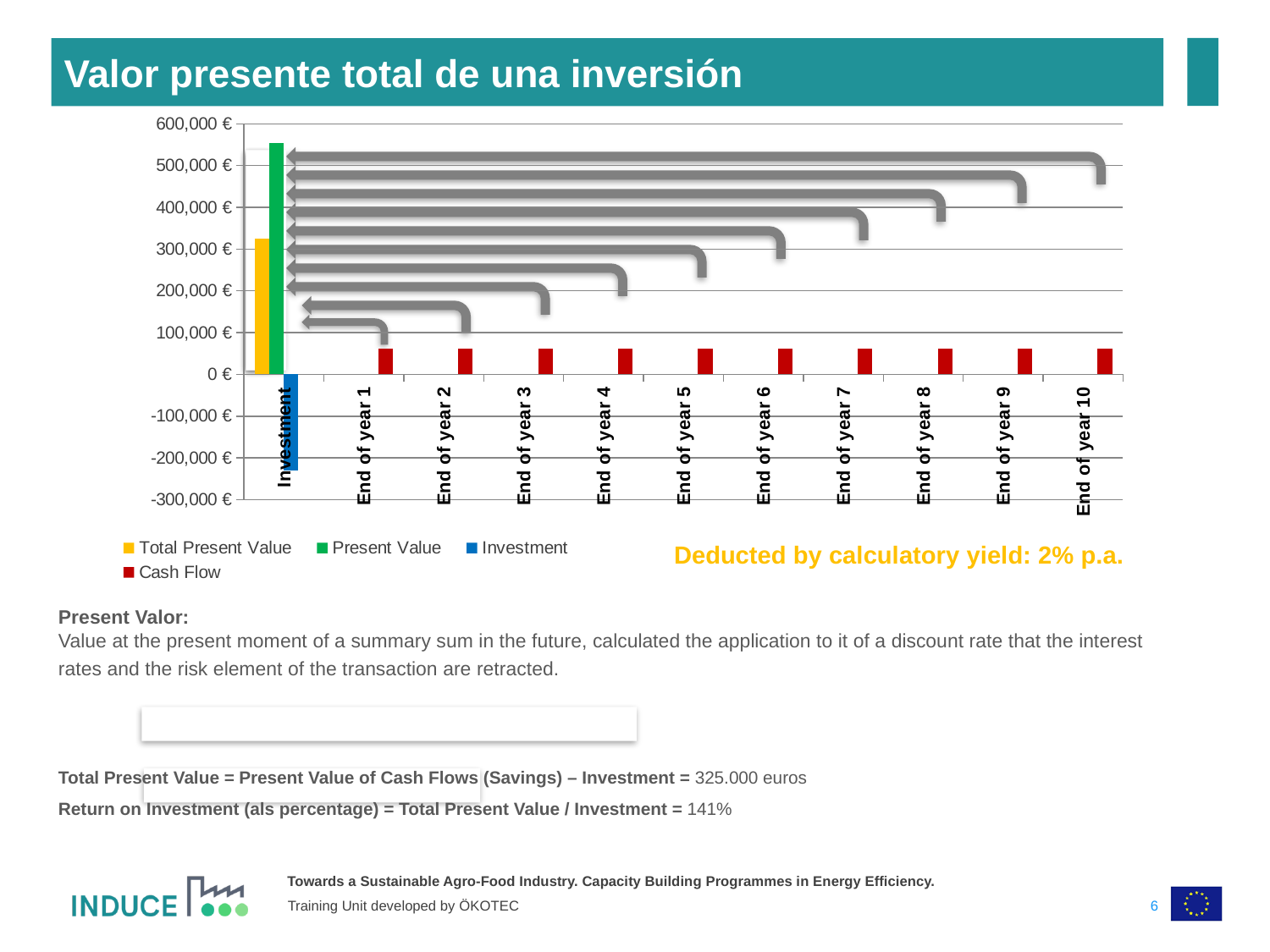
Which series has the tallest bar in the chart? Present Value What is the title of the slide containing the chart? Valor presente total de una inversión Which is larger in the Investment category: the Present Value bar or the Total Present Value bar? Present Value Is the Present Value bar greater or less than 500,000 €? greater What colour is used for the Cash Flow series in the chart? red Is the Investment bar greater or less than -100,000 €? less Is the Cash Flow bar for End of year 1 greater or less than 100,000 €? less What kind of chart is shown on the slide? bar chart How many series does the chart legend list? 4 How many categories are shown along the x axis of the chart? 11 Do the Cash Flow bars rise, fall or stay roughly constant from End of year 1 to End of year 10? stay roughly constant